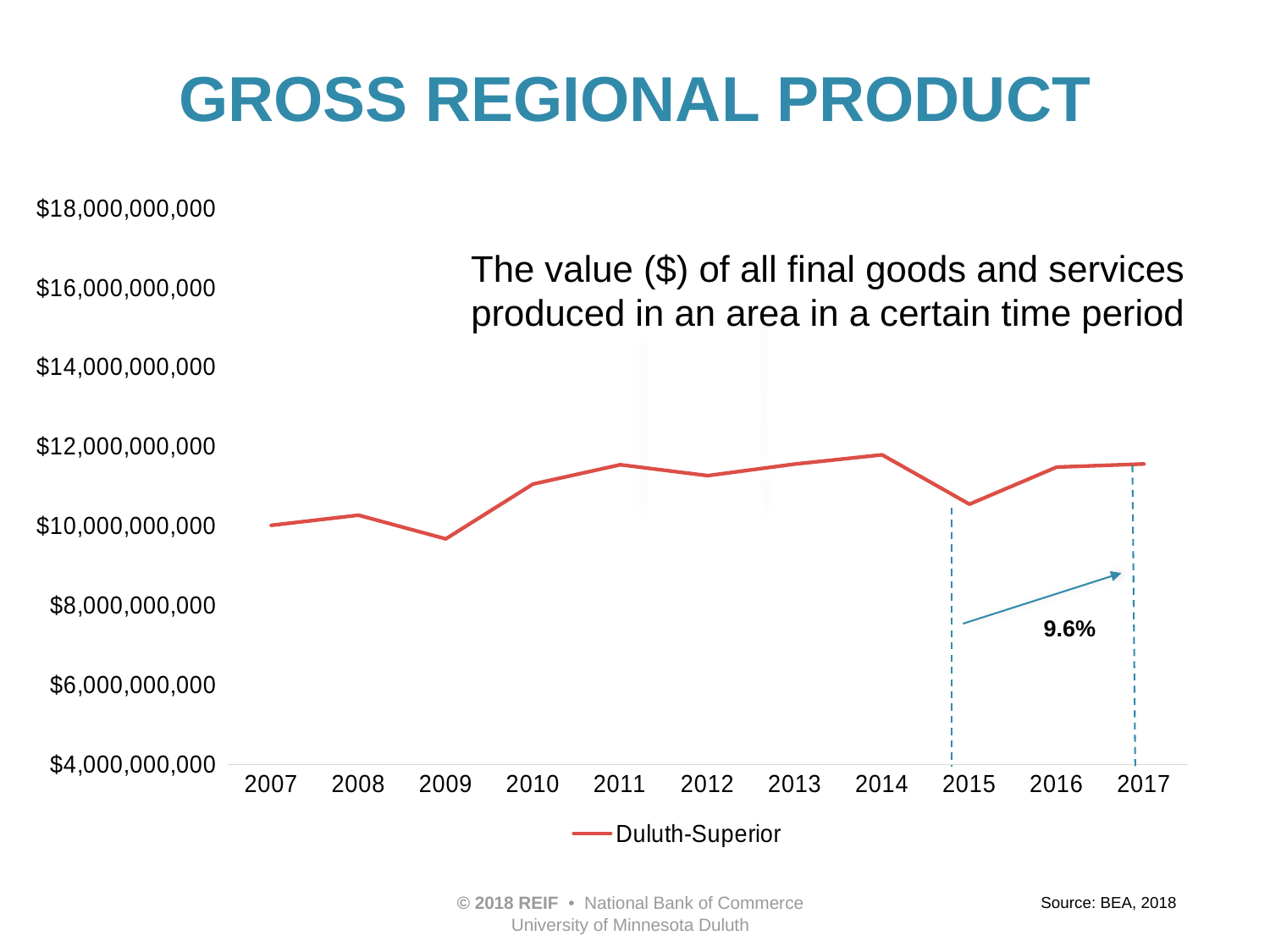
Which year has the lowest gross regional product for Duluth-Superior? 2009 Is the value for 2014 greater or less than $10,000,000,000? greater Is the value for 2015 greater or less than $12,000,000,000? less What kind of chart is shown on the slide? line chart Is the value for 2009 greater or less than $10,000,000,000? less Which year has the larger value, 2014 or 2015? 2014 Does the Duluth-Superior line rise or fall from 2015 to 2017? rise Which year has the larger value, 2009 or 2010? 2010 What percentage change is annotated between 2015 and 2017? 9.6% What is the name of the series shown in the legend? Duluth-Superior How many series does the legend list? 1 How many years are plotted along the x axis? 11